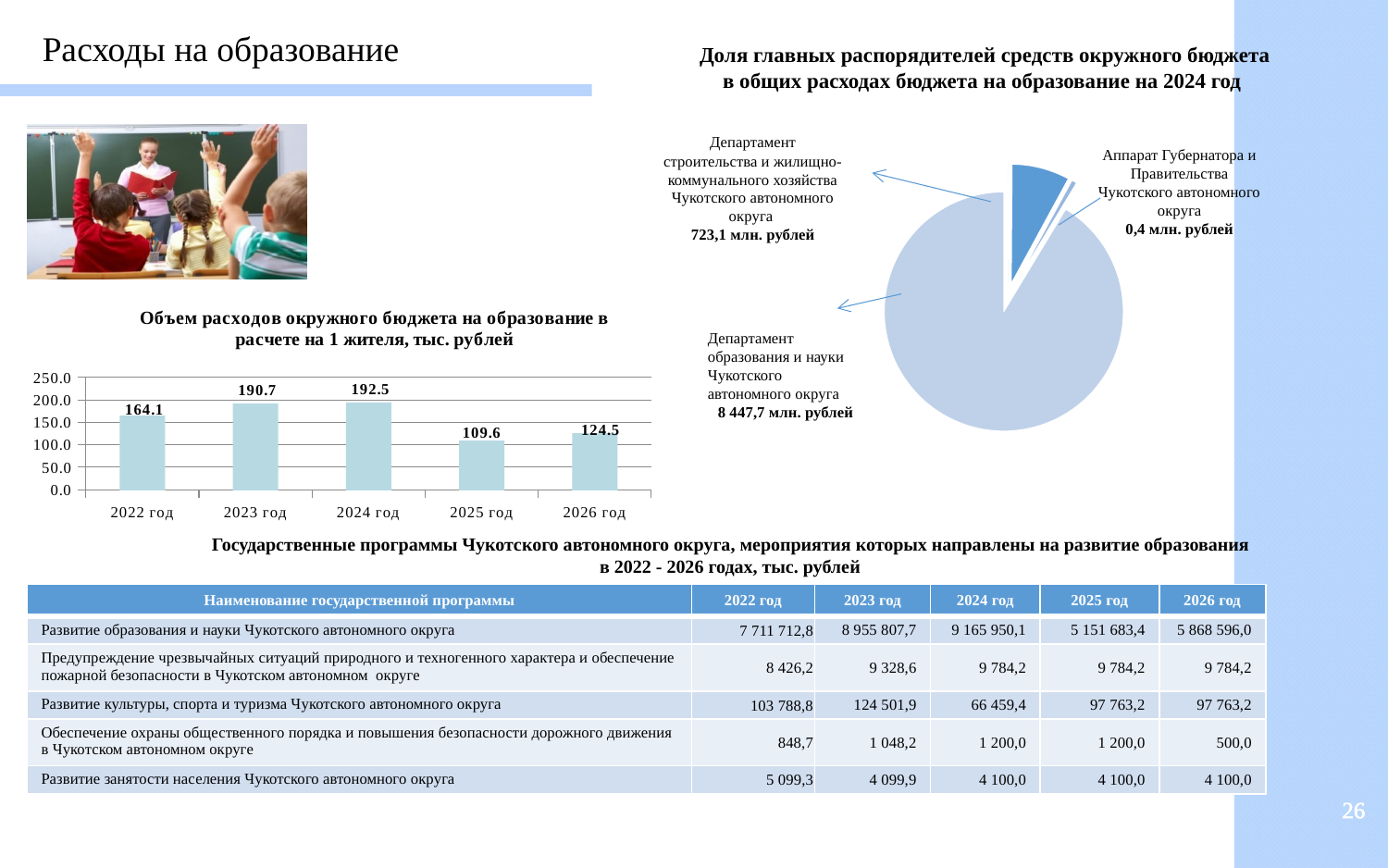
In the pie chart 'Доля главных распорядителей средств окружного бюджета в общих расходах бюджета на образование на 2024 год', what is the value for Аппарат Губернатора и Правительства Чукотского автономного округа? 0,4 млн. рублей In the pie chart 'Доля главных распорядителей средств окружного бюджета в общих расходах бюджета на образование на 2024 год', what is the value for Департамент образования и науки Чукотского автономного округа? 8 447,7 млн. рублей In the bar chart 'Объем расходов окружного бюджета на образование в расчете на 1 жителя, тыс. рублей', what is the value for 2025 год? 109.6 In the bar chart 'Объем расходов окружного бюджета на образование в расчете на 1 жителя, тыс. рублей', how many years are shown on the x axis? 5 In the bar chart 'Объем расходов окружного бюджета на образование в расчете на 1 жителя, тыс. рублей', what is the difference between the values for 2023 год and 2026 год? 66.2 In the bar chart 'Объем расходов окружного бюджета на образование в расчете на 1 жителя, тыс. рублей', which is larger: the value for 2022 год or the value for 2026 год? 2022 год In the bar chart 'Объем расходов окружного бюджета на образование в расчете на 1 жителя, тыс. рублей', which year has the highest value? 2024 год In the bar chart 'Объем расходов окружного бюджета на образование в расчете на 1 жителя, тыс. рублей', do the values rise or fall from 2024 год to 2025 год? fall In the bar chart 'Объем расходов окружного бюджета на образование в расчете на 1 жителя, тыс. рублей', which year has the lowest value? 2025 год What kind of chart is 'Объем расходов окружного бюджета на образование в расчете на 1 жителя, тыс. рублей'? bar chart In the bar chart 'Объем расходов окружного бюджета на образование в расчете на 1 жителя, тыс. рублей', what is the value for 2022 год? 164.1